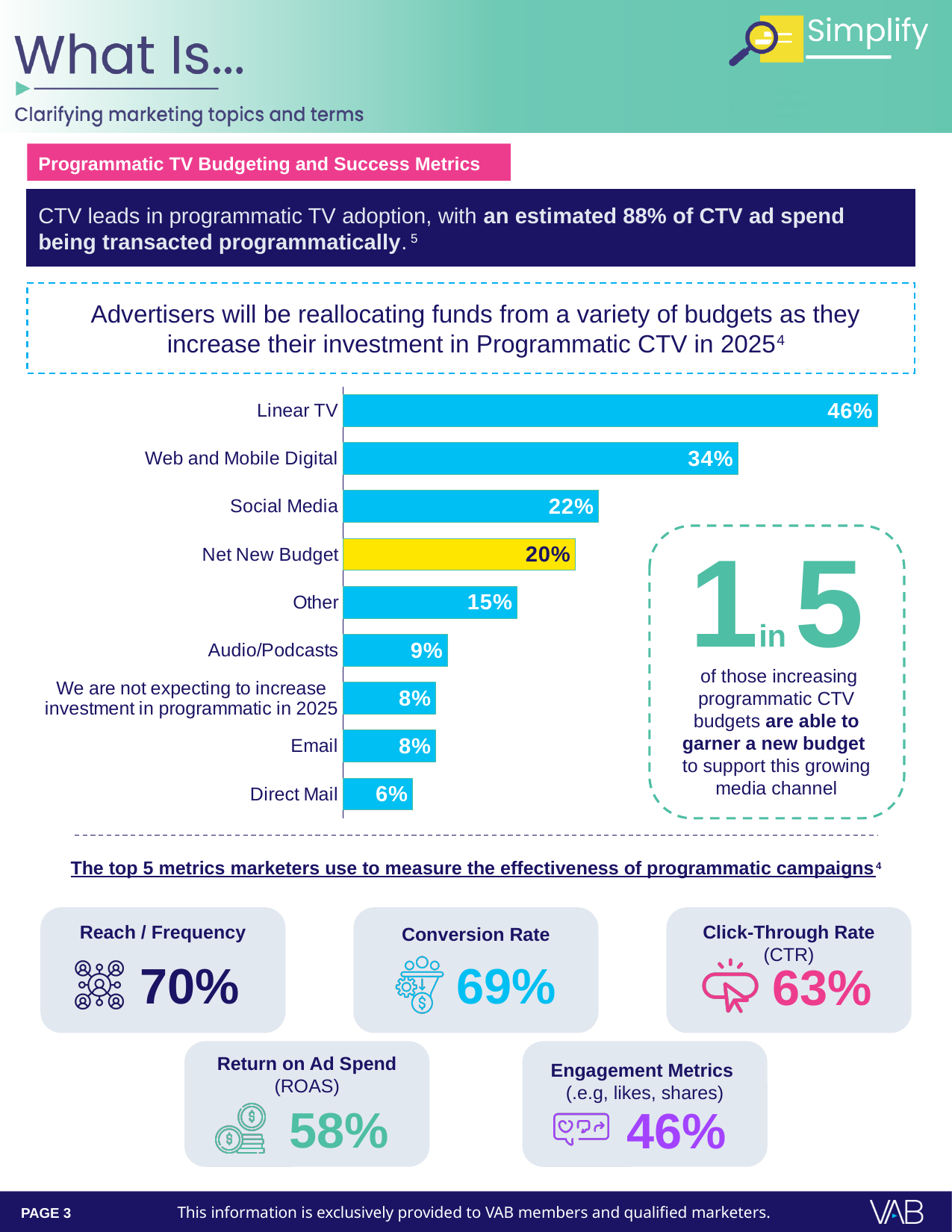
Which category has the lowest value in the bar chart? Direct Mail What value is shown for Audio/Podcasts in the bar chart? 9% What value does the bar chart show for Social Media? 22% Which bar in the chart is coloured yellow rather than blue? Net New Budget What is the difference between the values for Linear TV and Web and Mobile Digital? 12 percentage points Which is larger in the bar chart: Other or Audio/Podcasts? Other What kind of chart is used to show the budget sources advertisers will reallocate from? Bar chart Which category has the highest value in the bar chart? Linear TV What percentage is shown for Net New Budget? 20% What percentage is shown for Linear TV in the bar chart? 46% What is the difference between the values for Email and Direct Mail? 2 percentage points How many categories are shown in the bar chart? 9